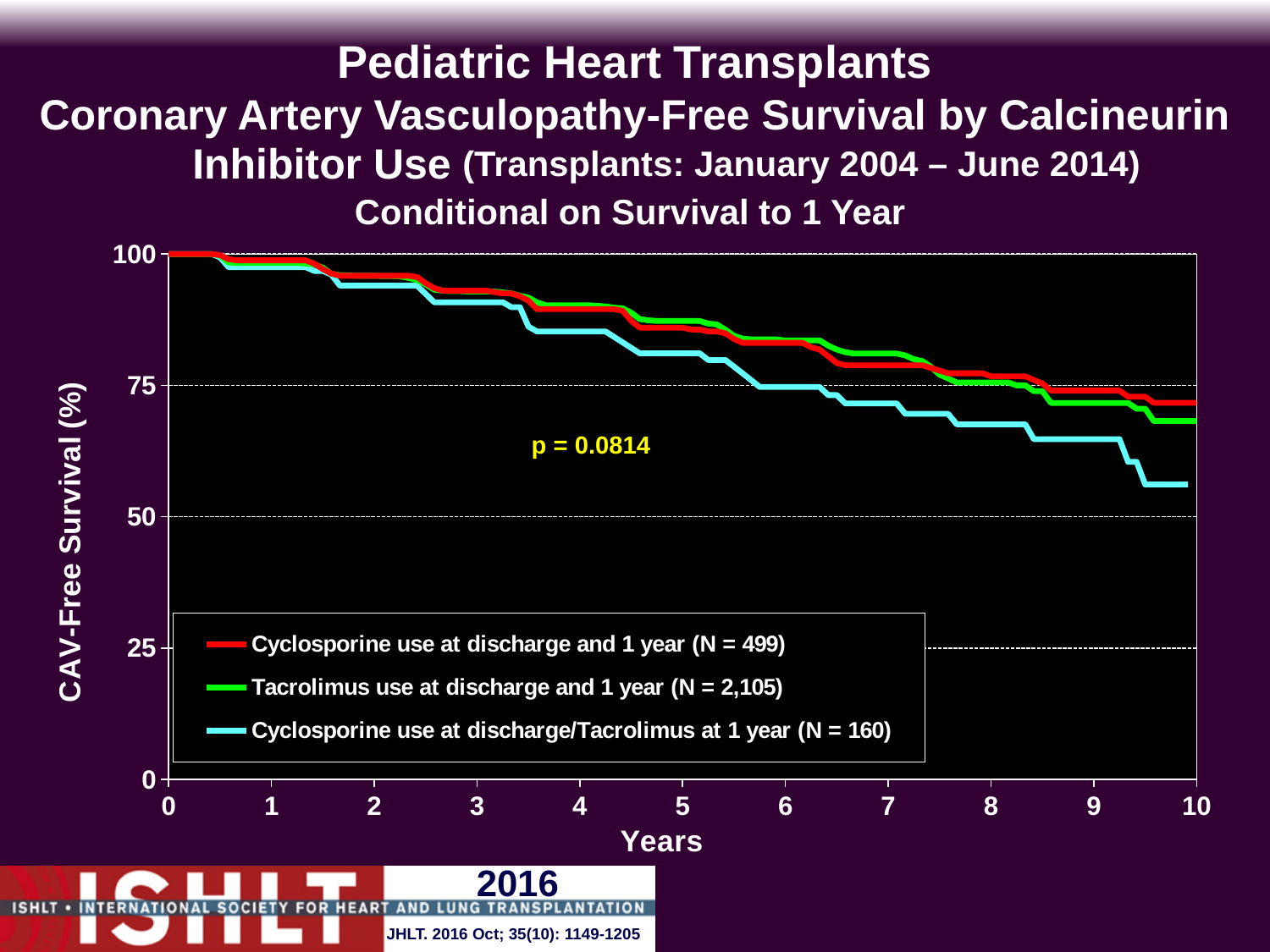
What is the p-value printed on the chart? p = 0.0814 What is the N for the Tacrolimus use at discharge and 1 year group shown in the legend? 2,105 Is the CAV-free survival for the Cyclosporine use at discharge and 1 year group at 5 years greater or less than 75? greater Is the CAV-free survival for the Tacrolimus use at discharge and 1 year group at 10 years greater or less than 50? greater Is the CAV-free survival for the Cyclosporine use at discharge/Tacrolimus at 1 year group at 10 years greater or less than 75? less What is the label of the y axis? CAV-Free Survival (%) How many series does the legend list? 3 Do the CAV-free survival curves rise or fall as years increase? fall At 10 years, which is higher: CAV-free survival for the Cyclosporine use at discharge and 1 year group or the Cyclosporine use at discharge/Tacrolimus at 1 year group? Cyclosporine use at discharge and 1 year Which group has the lowest CAV-free survival at 10 years? Cyclosporine use at discharge/Tacrolimus at 1 year What kind of chart is shown on the slide? line chart